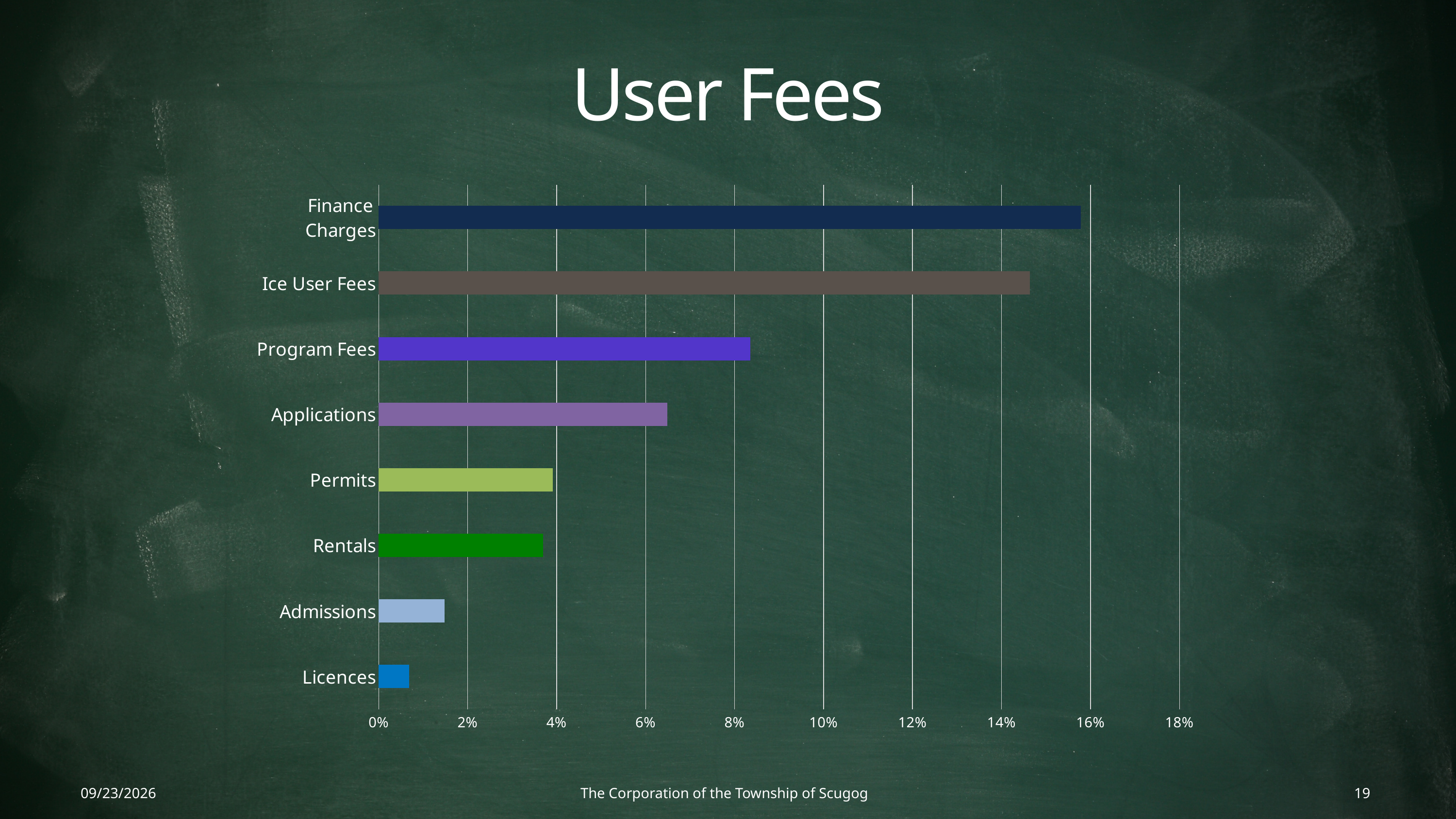
Is the value for Applications greater or less than 8%? less What kind of chart is shown on the slide? bar chart Which is larger, the value for Ice User Fees or the value for Permits? Ice User Fees Is the value for Program Fees greater or less than 6%? greater Is the value for Ice User Fees greater or less than 16%? less How many categories are plotted in the chart? 8 Which category has the lowest value? Licences Which category has the highest value? Finance Charges What is the title of the chart? User Fees Which is larger, the value for Program Fees or the value for Applications? Program Fees